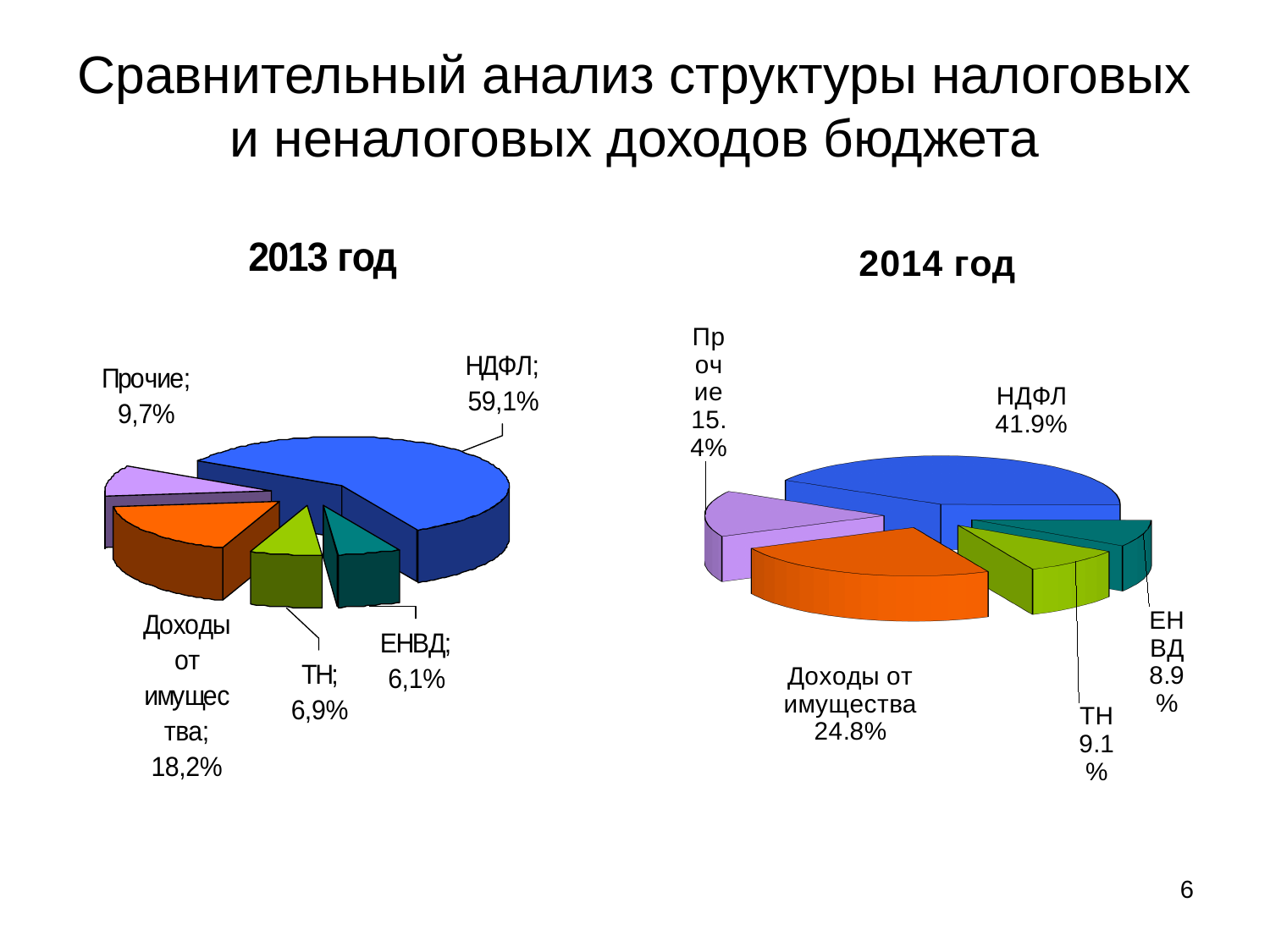
In the 2014 год chart, which category has the largest share? НДФЛ In the 2013 год chart, what is the difference between the shares of Доходы от имущества and Прочие? 8,5% What is the title of the chart on the right side of the slide? 2014 год In the 2013 год chart, which category has the largest share? НДФЛ In the 2014 год chart, what share does Доходы от имущества have? 24.8% In the 2013 год chart, which category has the smallest share? ЕНВД In the 2013 год chart, what is the value for Прочие? 9,7% What type of chart is the 2013 год chart? Pie chart In the 2013 год chart, what share does НДФЛ have? 59,1% In the 2014 год chart, which is larger, Прочие or ТН? Прочие In the 2014 год chart, what is the value for ТН? 9.1% How many categories are shown in the 2014 год chart? 5